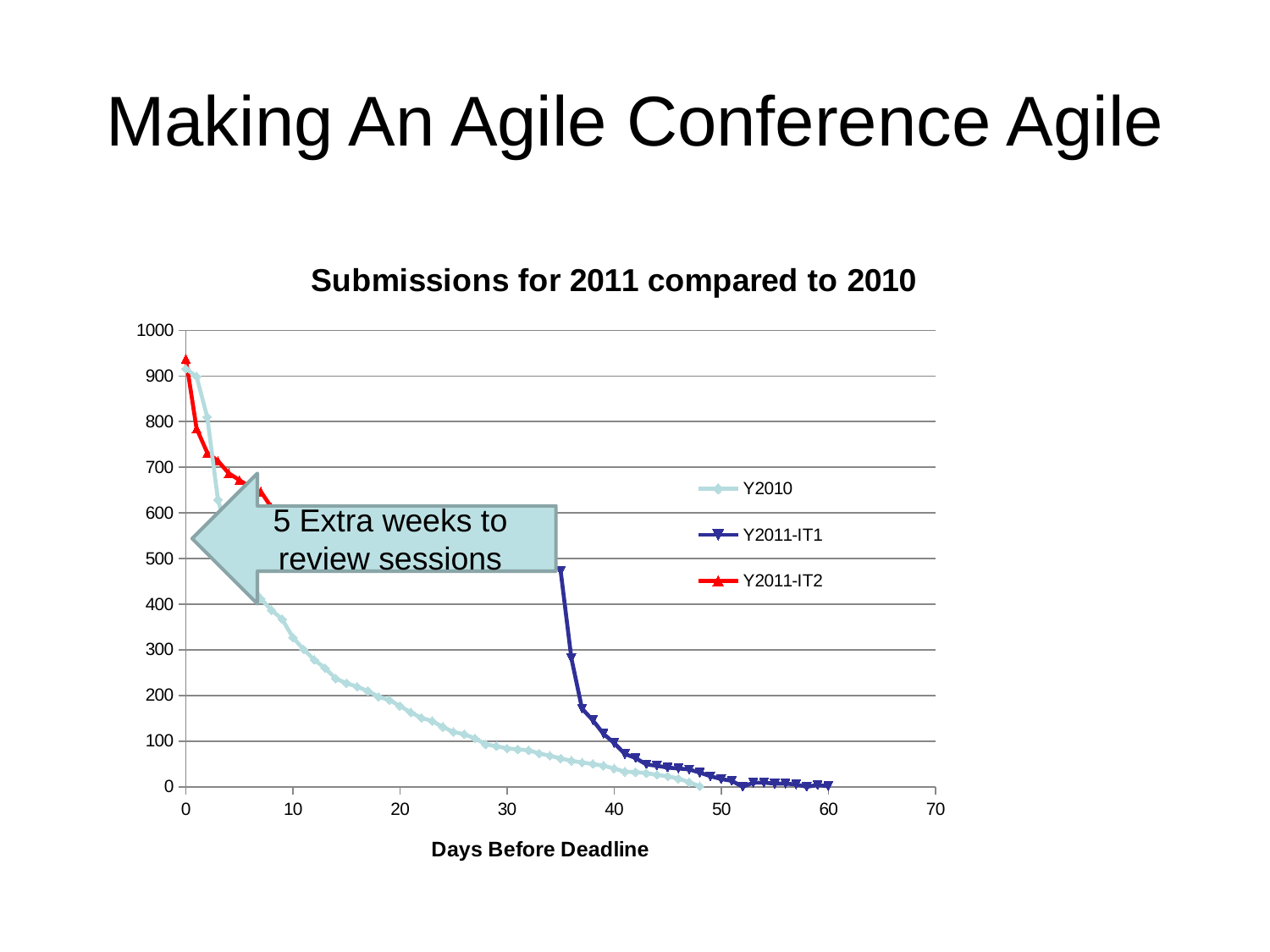
Do the values of the Y2011-IT1 series rise or fall as Days Before Deadline increases? fall At 5 days before deadline, which series has the larger value, Y2010 or Y2011-IT2? Y2011-IT2 Is the value of Y2011-IT2 at 0 days before deadline greater or less than 900? greater How many series does the chart's legend list? 3 Is the value of Y2010 at 20 days before deadline greater or less than 200? less What is the title of the chart? Submissions for 2011 compared to 2010 Is the value of Y2010 at 10 days before deadline greater or less than 300? greater What are the series names listed in the chart's legend? Y2010, Y2011-IT1, Y2011-IT2 What kind of chart is shown on the slide? line chart Do the values of the Y2010 series rise or fall as Days Before Deadline increases? fall